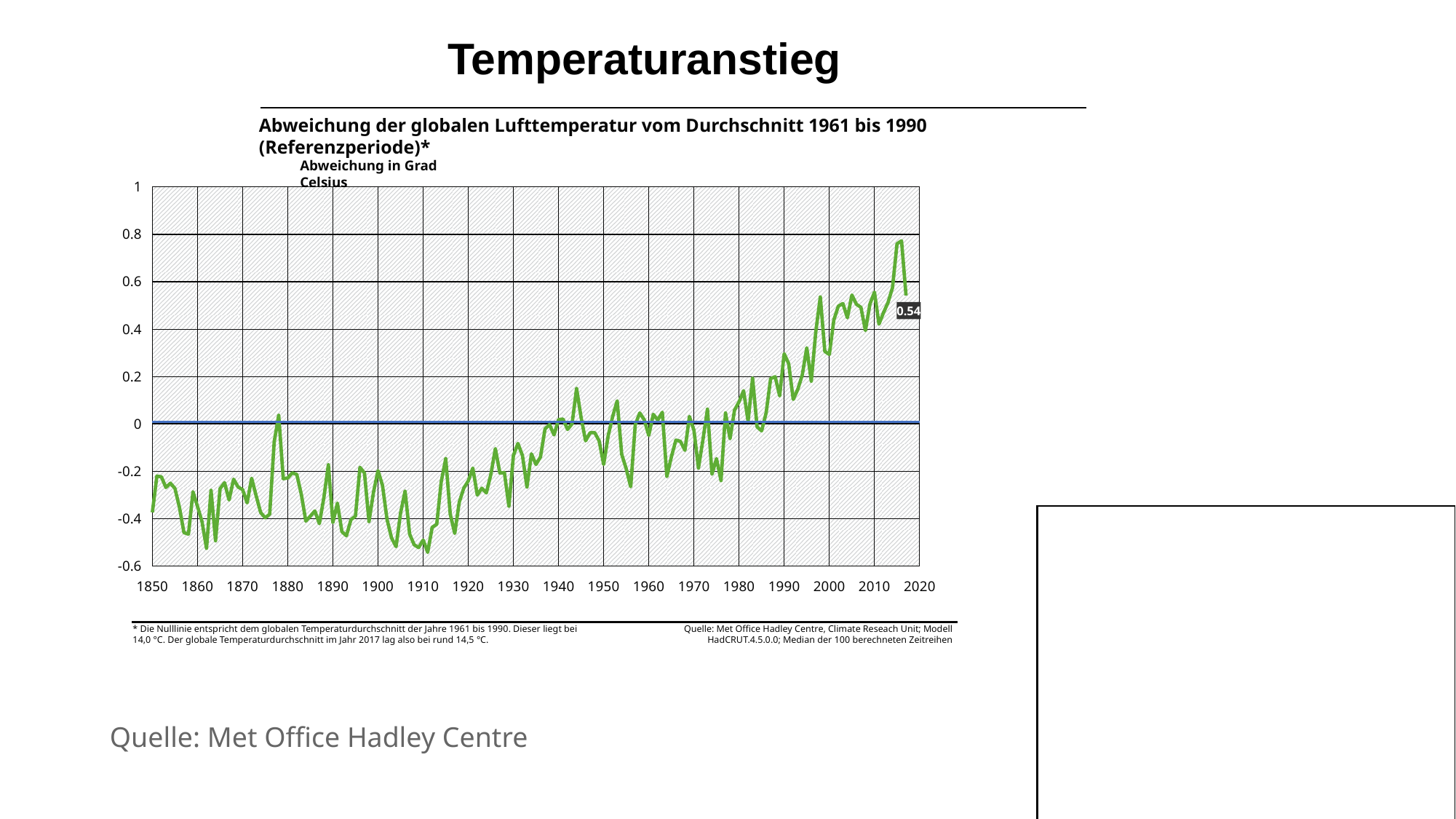
What is the value shown by the data label at the end of the line? 0.54 Is the value for 1990 greater or less than 0? greater What is the title of the chart? Abweichung der globalen Lufttemperatur vom Durchschnitt 1961 bis 1990 (Referenzperiode)* Overall, do the values rise or fall from 1850 to 2020? rise What kind of chart is shown on the slide? line chart In which decade does the line reach its highest value? 2010s What is the label of the vertical axis? Abweichung in Grad Celsius Is the lowest value on the line greater or less than -0.4? less Is the value for 1850 greater or less than 0? less Which is larger, the value for 1950 or the value for 2010? 2010